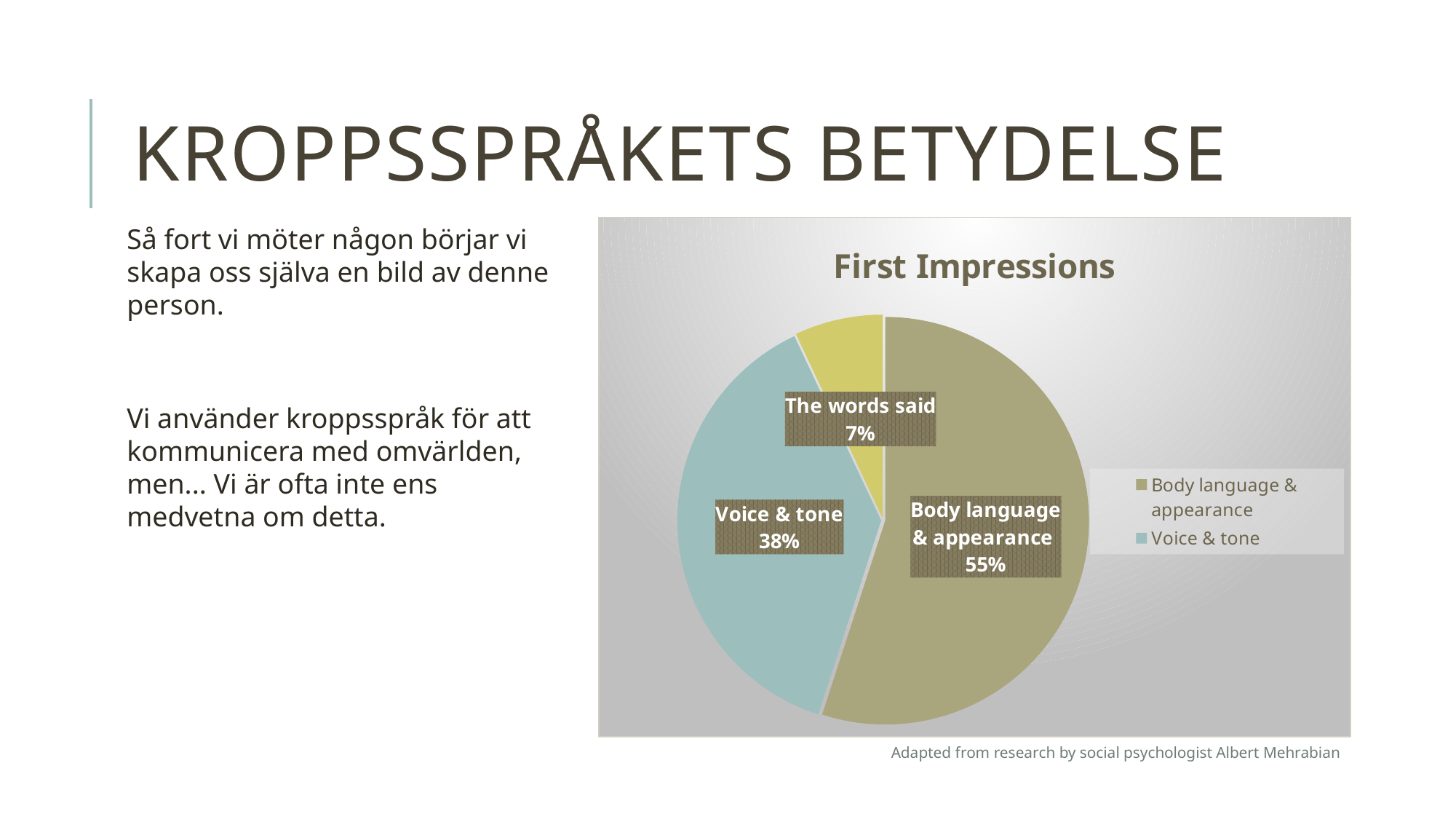
Which slice of the pie is the smallest? The words said What type of chart is shown on the slide? pie chart Which slice of the pie is the largest? Body language & appearance Which is larger, Voice & tone or The words said? Voice & tone What share of the pie is labelled for Body language & appearance? 55% What is the difference in percentage points between Voice & tone and The words said? 31 What is the difference in percentage points between Body language & appearance and Voice & tone? 17 What share of the pie is labelled for The words said? 7% What share of the pie is labelled for Voice & tone? 38% How many entries does the legend list? 2 How many slices does the pie chart have? 3 What is the title of the chart? First Impressions